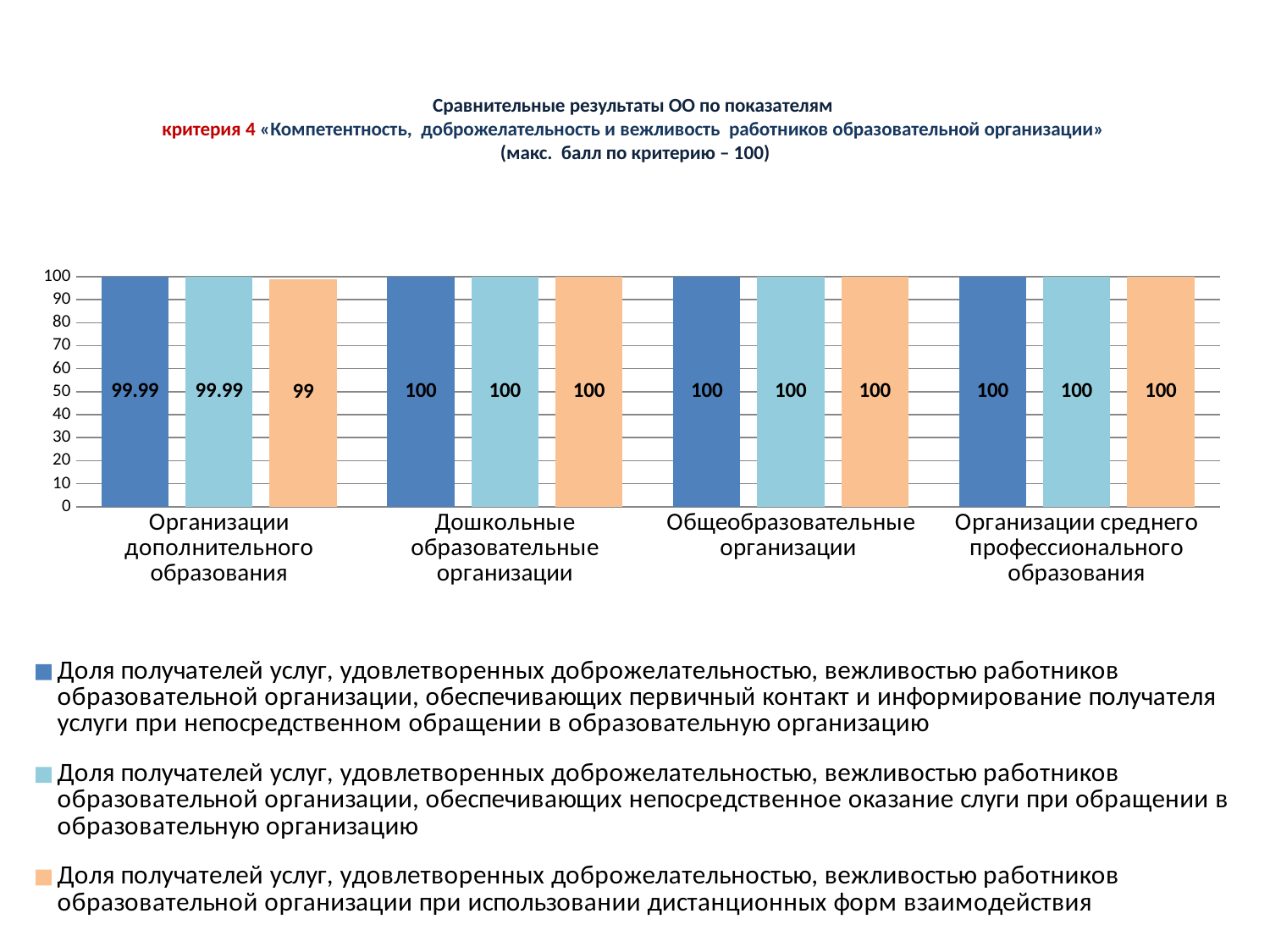
What is the value of the orange bar for Общеобразовательные организации? 100 What is the value of the dark blue bar (первичный контакт series) for Организации дополнительного образования? 99.99 Which is larger: the dark blue bar for Организации дополнительного образования or the dark blue bar for Организации среднего профессионального образования? Организации среднего профессионального образования What type of chart is shown on the slide? bar chart How many categories are shown on the x axis of the chart? 4 Which category has the lowest value for the orange (дистанционных форм взаимодействия) series? Организации дополнительного образования What is the maximum score per criterion stated in the chart title? 100 What is the difference between the orange bar for Дошкольные образовательные организации and the orange bar for Организации дополнительного образования? 1 What is the value of the light blue bar (непосредственное оказание услуги series) for Дошкольные образовательные организации? 100 What colour are the bars for the series about дистанционных форм взаимодействия? orange What is the value of the orange bar (дистанционных форм взаимодействия series) for Организации дополнительного образования? 99 How many series does the legend list? 3